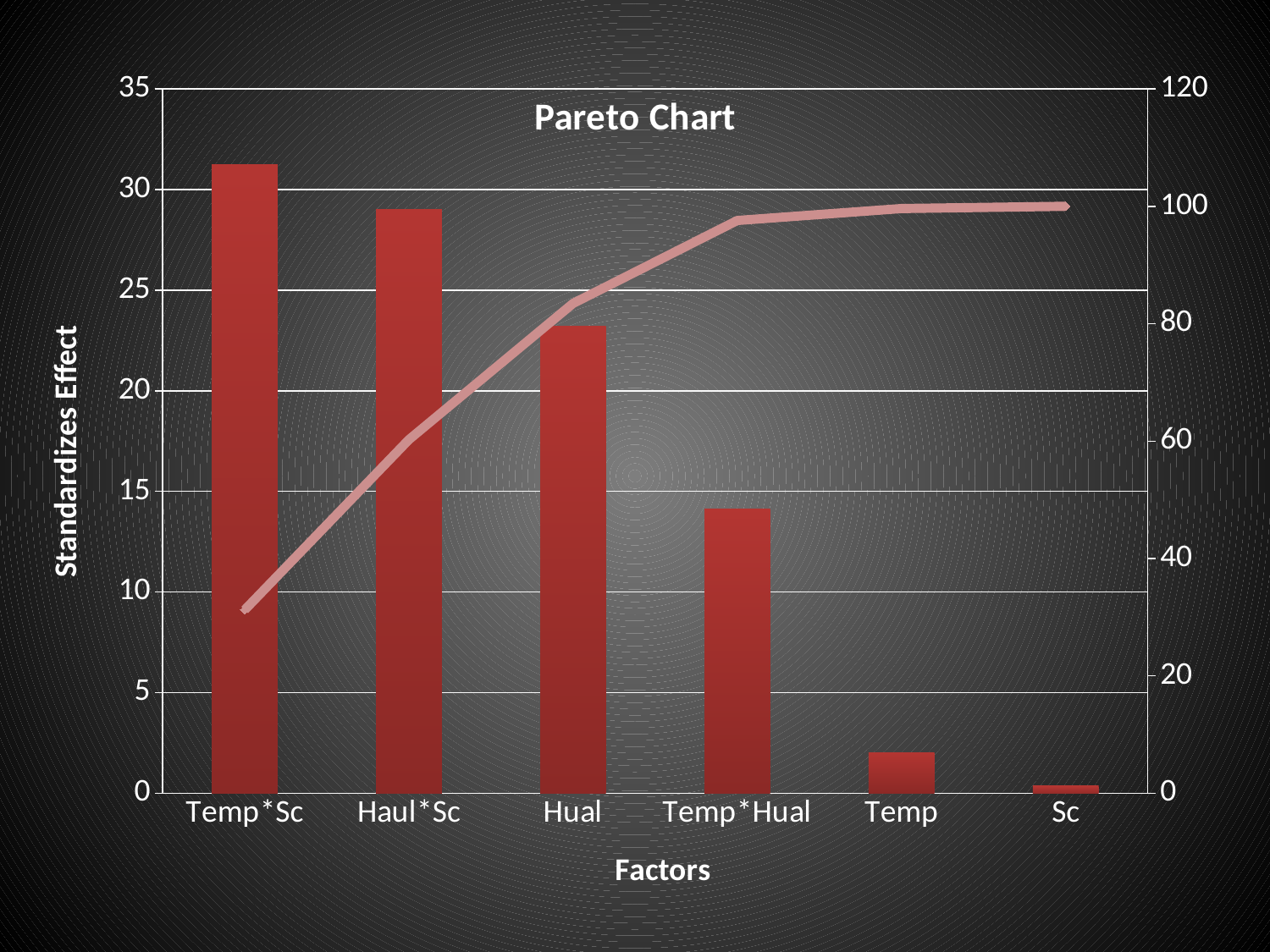
Is the standardized effect for Hual greater or less than 25? less Which has a larger standardized effect, Hual or Temp*Hual? Hual What is the label of the left vertical axis? Standardizes Effect How many factors are shown on the x axis? 6 Which factor has the lowest standardized effect? Sc Do the bar values rise or fall from left to right along the x axis? fall Which factor has the highest standardized effect? Temp*Sc What type of chart is shown on the slide? Bar chart with a line Is the standardized effect for Temp*Sc greater or less than 30? greater Is the standardized effect for Haul*Sc greater or less than 30? less What is the title of the chart? Pareto Chart